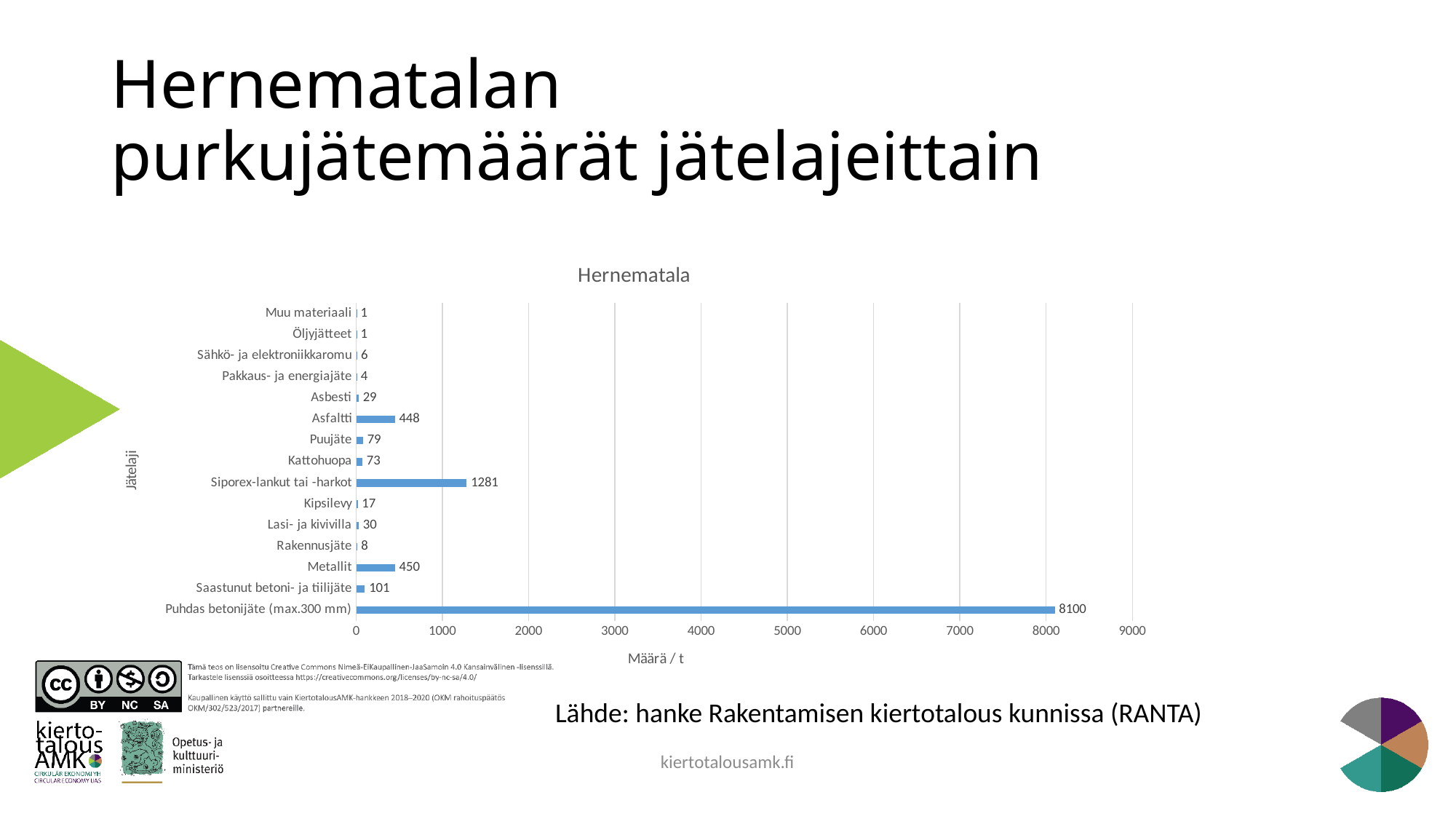
What is the difference between the values for Metallit and Asfaltti? 2 What is the title of the chart? Hernematala What is the value for Asfaltti? 448 Is the value for Puhdas betonijäte (max.300 mm) greater or less than 8000? greater Which category has the highest value? Puhdas betonijäte (max.300 mm) What is the difference between the values for Puhdas betonijäte (max.300 mm) and Siporex-lankut tai -harkot? 6819 What is the value for Siporex-lankut tai -harkot? 1281 How many categories are shown on the chart? 15 What kind of chart is shown? bar chart Which is larger, the value for Puujäte or the value for Kattohuopa? Puujäte What is the value for Saastunut betoni- ja tiilijäte? 101 What is the value for Asbesti? 29